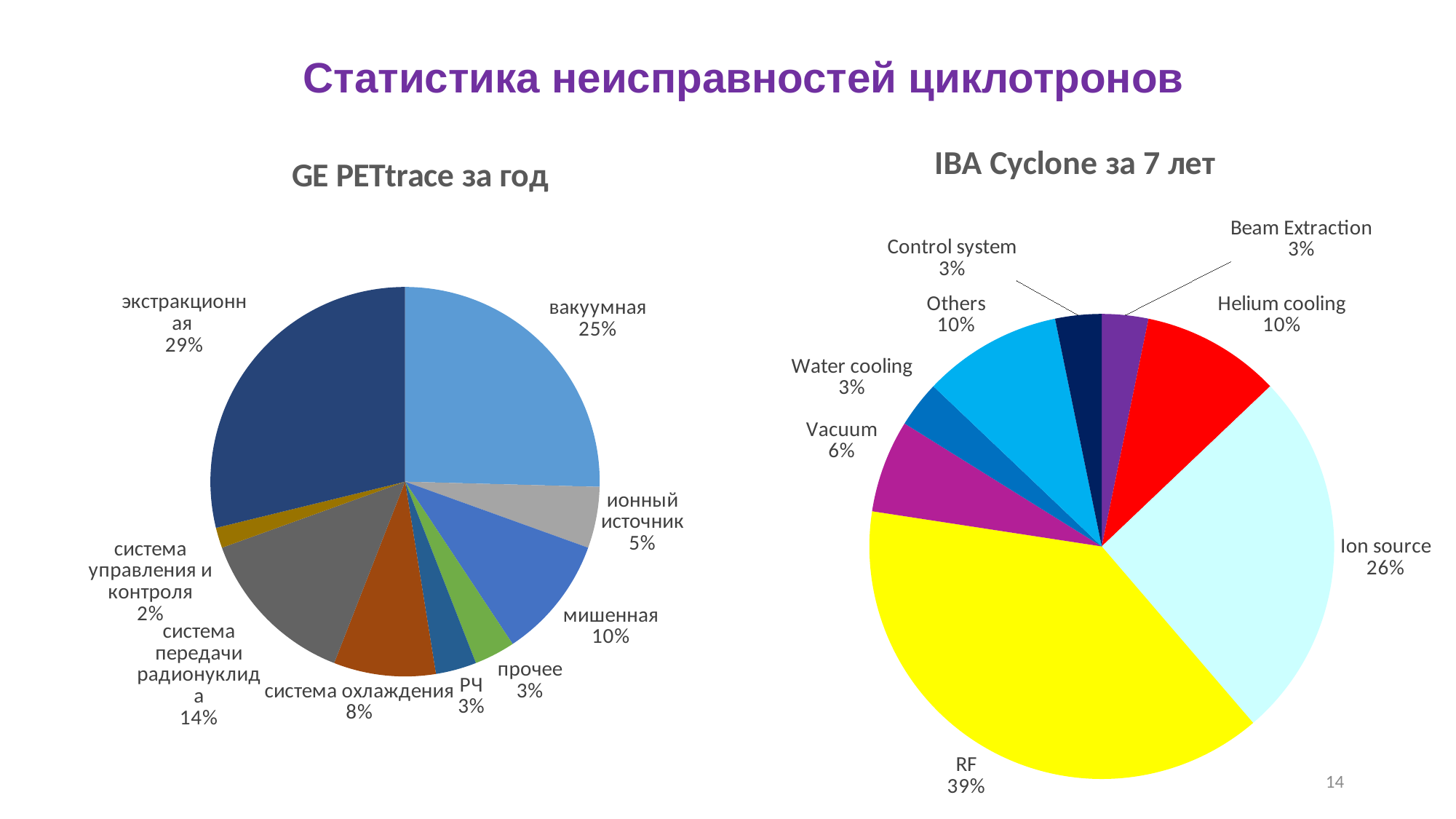
In the 'GE PETtrace за год' chart, which category has the smallest share? система управления и контроля In the 'GE PETtrace за год' chart, what share does the 'вакуумная' slice have? 25% In the 'IBA Cyclone за 7 лет' chart, what is the value for 'Ion source'? 26% In the 'GE PETtrace за год' chart, what is the difference between 'мишенная' and 'система охлаждения'? 2% In the 'IBA Cyclone за 7 лет' chart, which is larger, 'Helium cooling' or 'Vacuum'? Helium cooling In the 'IBA Cyclone за 7 лет' chart, what is the difference between 'RF' and 'Ion source'? 13% In the 'GE PETtrace за год' chart, which category has the largest share? экстракционная In the 'GE PETtrace за год' chart, how many slices does the pie have? 9 In the 'GE PETtrace за год' chart, what is the value for 'система передачи радионуклида'? 14% In the 'IBA Cyclone за 7 лет' chart, how many slices does the pie have? 8 What type of chart is used for 'IBA Cyclone за 7 лет'? pie chart In the 'IBA Cyclone за 7 лет' chart, which category has the largest share? RF